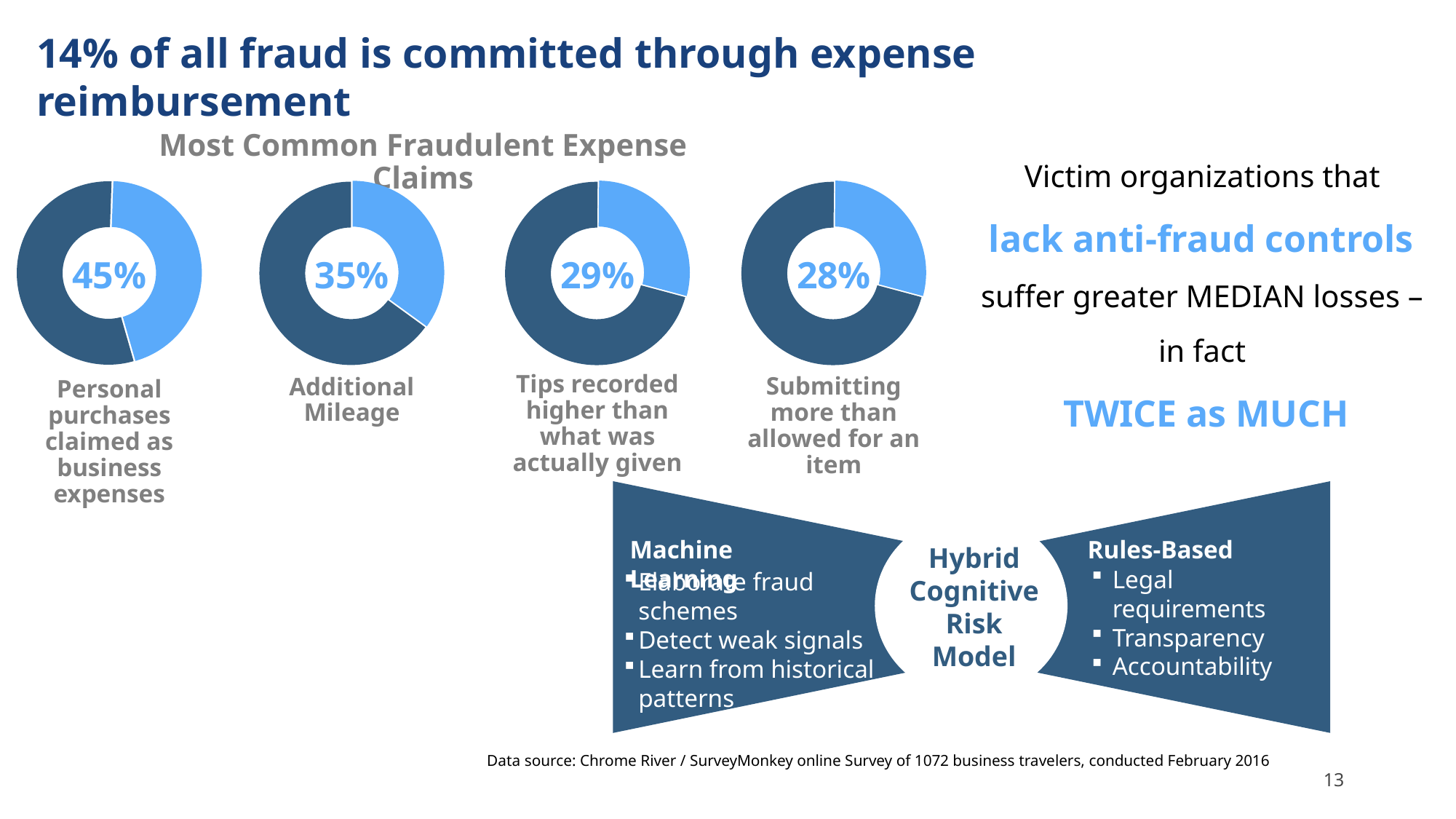
Among the 'Most Common Fraudulent Expense Claims' charts, which category has the highest percentage? Personal purchases claimed as business expenses How many donut charts are shown under the 'Most Common Fraudulent Expense Claims' heading? 4 In the 'Most Common Fraudulent Expense Claims' charts, what percentage is shown for tips recorded higher than what was actually given? 29% Among the 'Most Common Fraudulent Expense Claims' charts, which category has the lowest percentage? Submitting more than allowed for an item In the 'Most Common Fraudulent Expense Claims' charts, what percentage is shown for personal purchases claimed as business expenses? 45% In the 'Most Common Fraudulent Expense Claims' charts, which is larger: the percentage for additional mileage or the percentage for tips recorded higher than what was actually given? Additional Mileage What is the title above the four donut charts on the slide? Most Common Fraudulent Expense Claims In the 'Most Common Fraudulent Expense Claims' charts, what percentage is shown for submitting more than allowed for an item? 28% In the 'Most Common Fraudulent Expense Claims' charts, what percentage is shown for additional mileage? 35% In the 'Most Common Fraudulent Expense Claims' charts, what share of the donut for additional mileage is highlighted in light blue? 35% In the 'Most Common Fraudulent Expense Claims' charts, what is the difference between the percentage for personal purchases claimed as business expenses and the percentage for additional mileage? 10% What kind of chart is used to show the 'Most Common Fraudulent Expense Claims' percentages? Donut chart